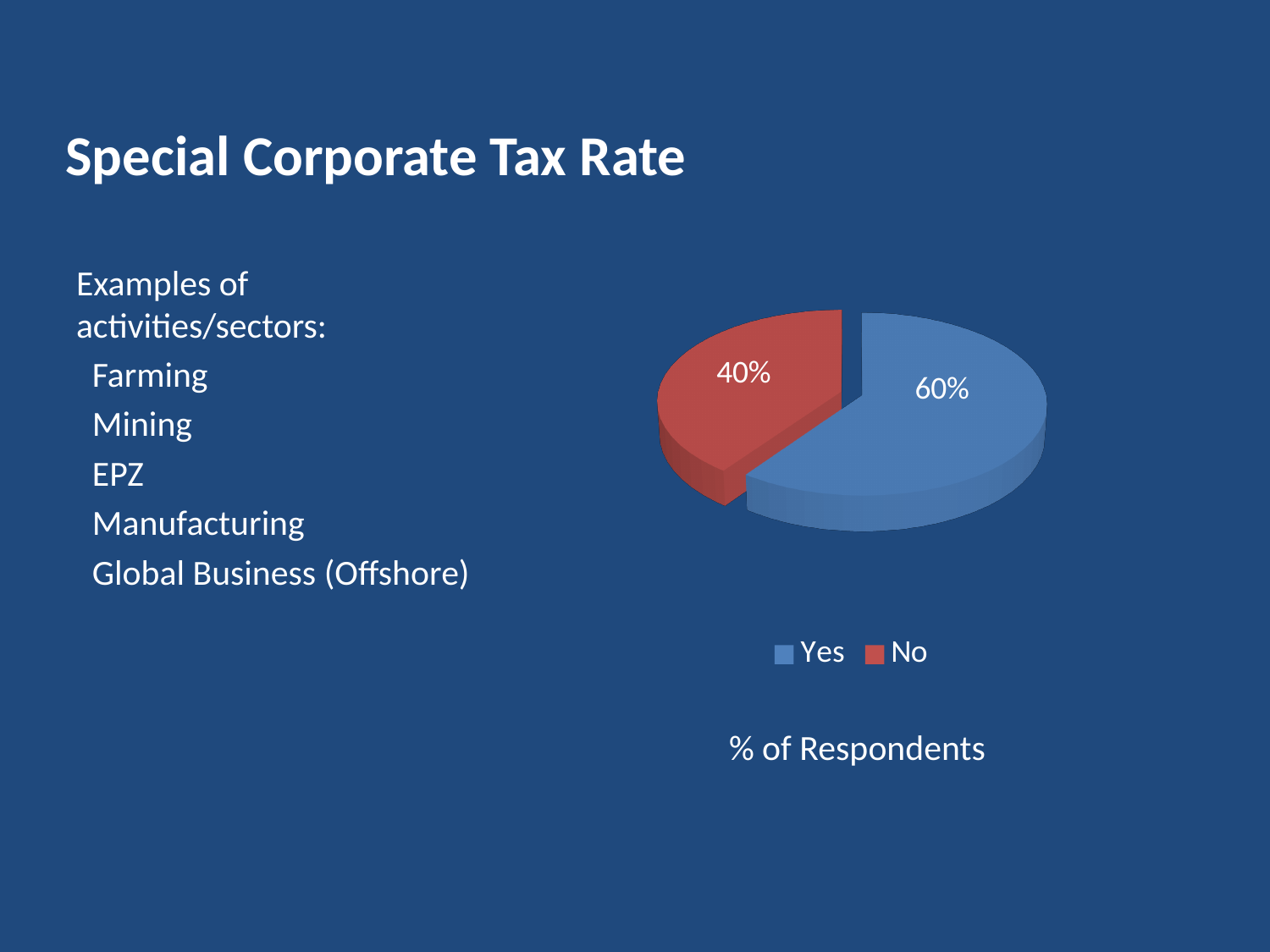
What colour is the Yes slice in the pie chart? blue What percentage of respondents answered Yes? 60% Which response has the smallest share of the pie? No Which slice is larger, Yes or No? Yes What label appears below the legend of the pie chart? % of Respondents Which response has the largest share of the pie? Yes What kind of chart is shown on the slide? pie chart How many slices does the pie chart have? 2 What percentage of respondents answered No? 40% What share of the pie does the No slice represent? 40% What is the difference in percentage points between the Yes and No slices? 20 percentage points How many entries does the legend list? 2